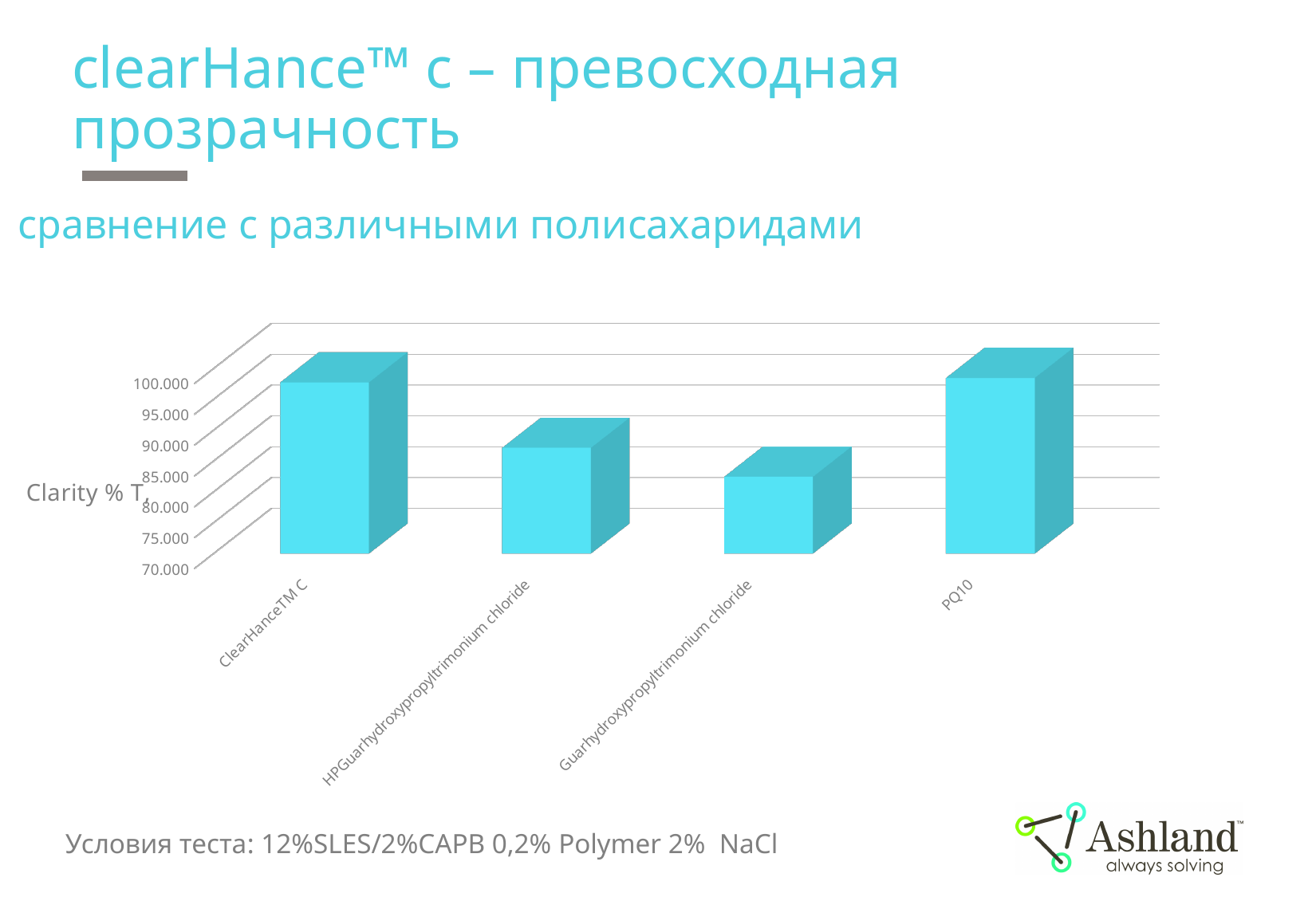
Is the value for Guarhydroxypropyltrimonium chloride greater or less than 90.000? less Which category has the lowest clarity value in the chart? Guarhydroxypropyltrimonium chloride Which has the larger clarity value: ClearHanceTM C or Guarhydroxypropyltrimonium chloride? ClearHanceTM C What is the label of the vertical axis of the chart? Clarity % T, Is the value for PQ10 greater or less than 90.000? greater Which has the larger clarity value: HPGuarhydroxypropyltrimonium chloride or Guarhydroxypropyltrimonium chloride? HPGuarhydroxypropyltrimonium chloride Is the value for ClearHanceTM C greater or less than 95.000? greater How many categories (bars) are plotted in the chart? 4 What kind of chart is shown on the slide? bar chart Which has the larger clarity value: PQ10 or HPGuarhydroxypropyltrimonium chloride? PQ10